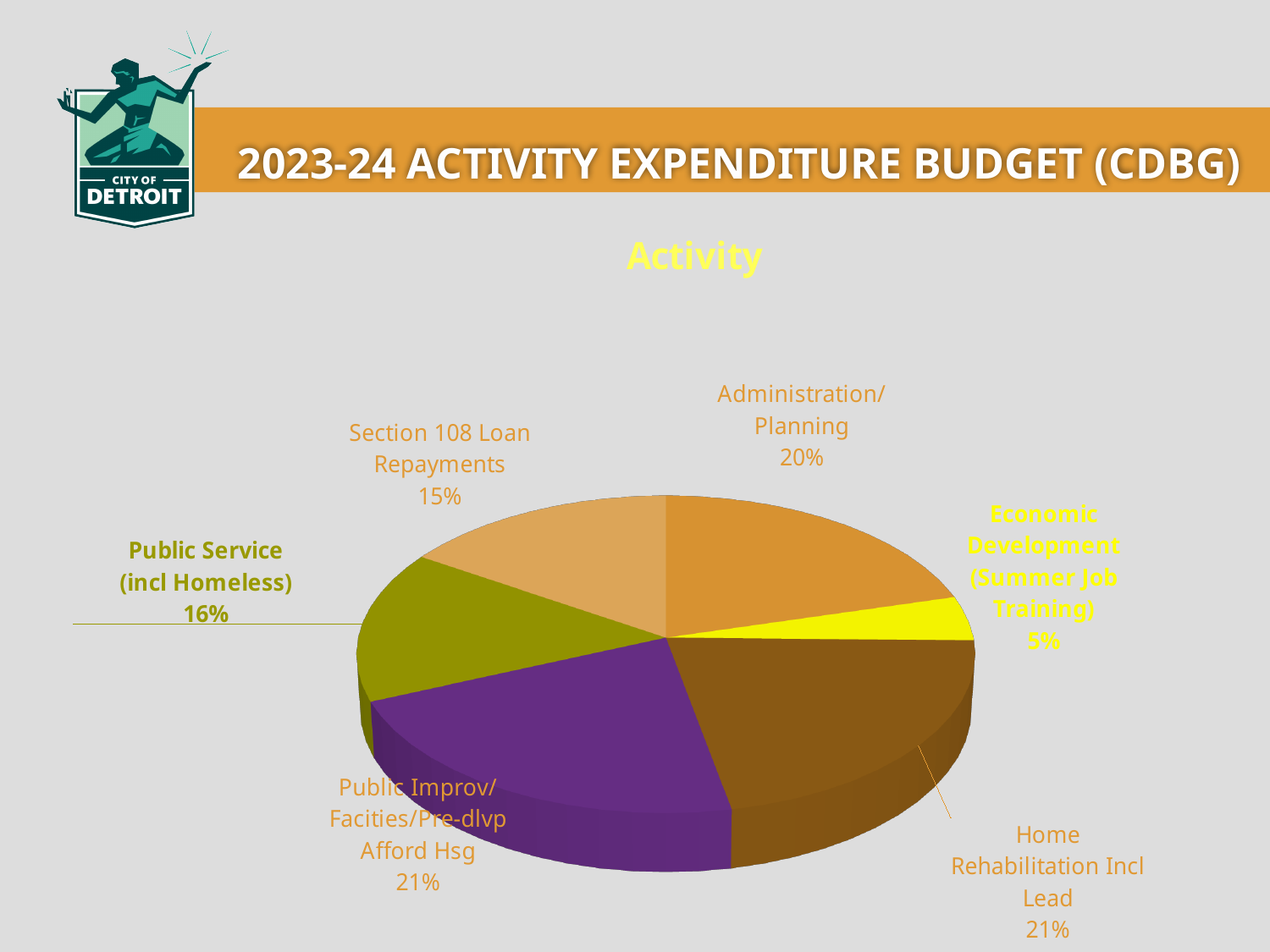
What share of the budget goes to Administration/Planning? 20% How many slices does the pie chart have? 6 What share of the budget goes to Public Service (incl Homeless)? 16% What kind of chart is shown on the slide? Pie chart What is the title of the chart? Activity What is the difference in percentage points between Home Rehabilitation Incl Lead and Public Service (incl Homeless)? 5 What share of the budget goes to Section 108 Loan Repayments? 15% What is the difference in percentage points between Administration/Planning and Economic Development (Summer Job Training)? 15 What share of the budget goes to Economic Development (Summer Job Training)? 5% Which is larger, the share for Public Service (incl Homeless) or the share for Section 108 Loan Repayments? Public Service (incl Homeless) What share of the budget goes to Home Rehabilitation Incl Lead? 21% Which activity has the smallest share of the budget? Economic Development (Summer Job Training)